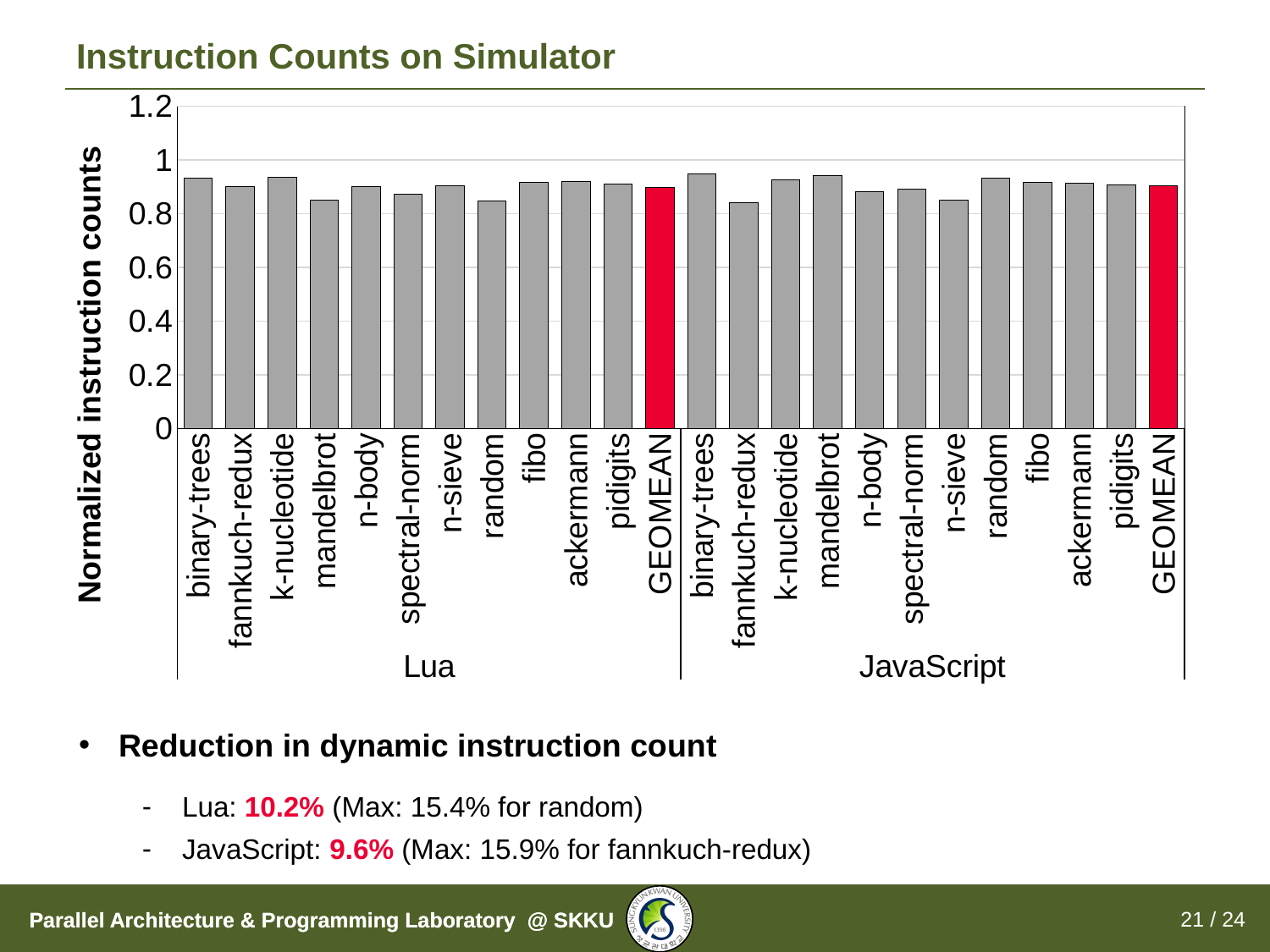
What kind of chart is shown on the slide? bar chart Is the value for binary-trees in the Lua group greater or less than 1? less Is the value for k-nucleotide in the JavaScript group greater or less than 0.8? greater In the Lua group, which is larger, the value for binary-trees or the value for mandelbrot? binary-trees Is the value for GEOMEAN in the JavaScript group greater or less than 1? less What is the title of the chart? Instruction Counts on Simulator How many bars are plotted in total across both groups? 24 In the JavaScript group, which is larger, the value for binary-trees or the value for fannkuch-redux? binary-trees How many bars are plotted in the Lua group? 12 What is the label of the y axis? Normalized instruction counts